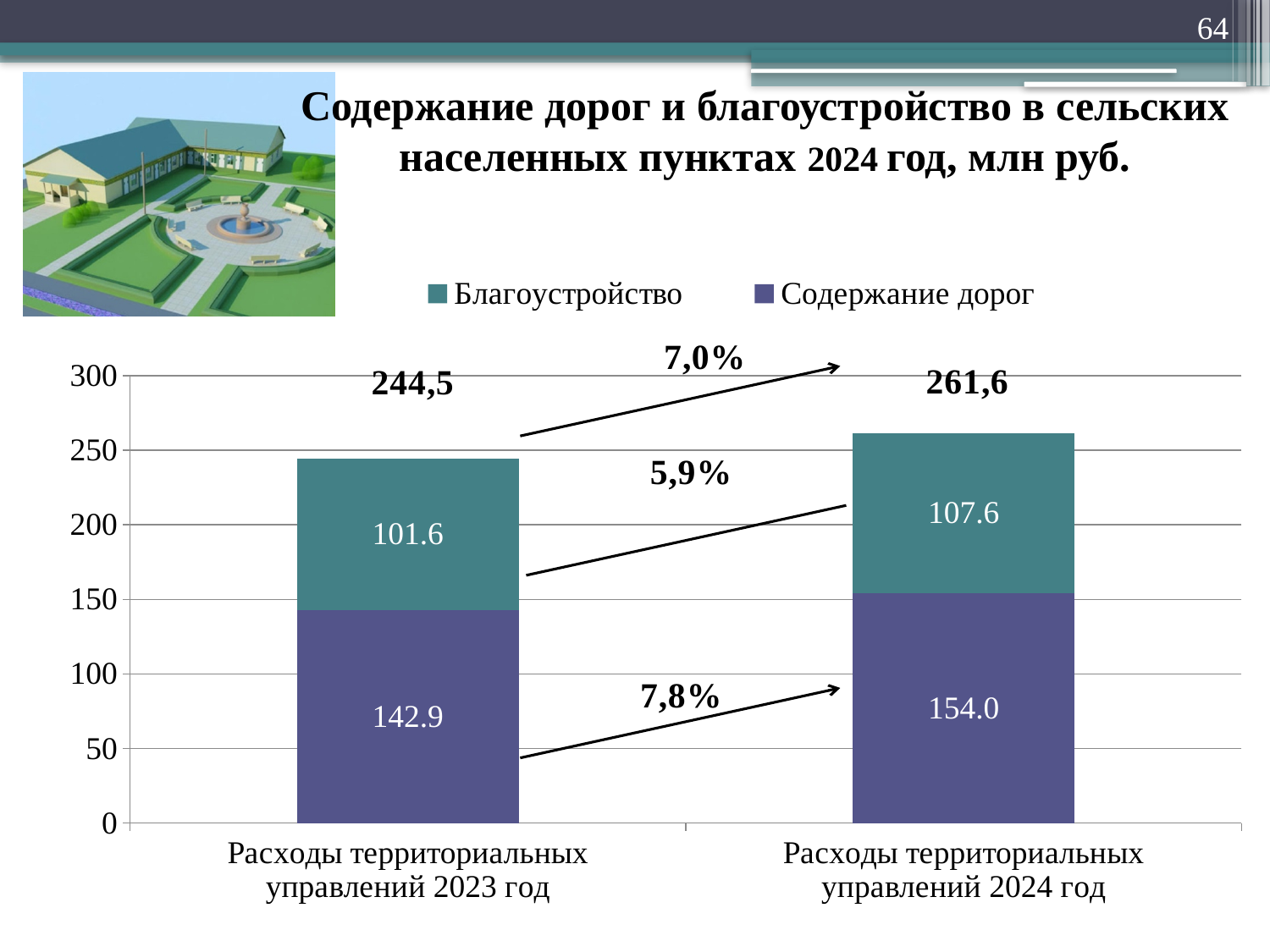
How many categories are shown on the x axis? 2 What is the value of Благоустройство for Расходы территориальных управлений 2023 год? 101.6 What is the value of Благоустройство for Расходы территориальных управлений 2024 год? 107.6 What percentage growth is shown for Содержание дорог between 2023 and 2024? 7,8% What type of chart is shown on the slide? Stacked bar chart Which is larger: Содержание дорог in 2023 or Благоустройство in 2023? Содержание дорог in 2023 How many series does the legend list? 2 What is the difference between the Содержание дорог values for 2024 and 2023? 11.1 Do the total expenses rise or fall from 2023 to 2024? Rise What is the total of the stacked bar for Расходы территориальных управлений 2023 год? 244,5 What is the value of Содержание дорог for Расходы территориальных управлений 2023 год? 142.9 What is the total of the stacked bar for Расходы территориальных управлений 2024 год? 261,6